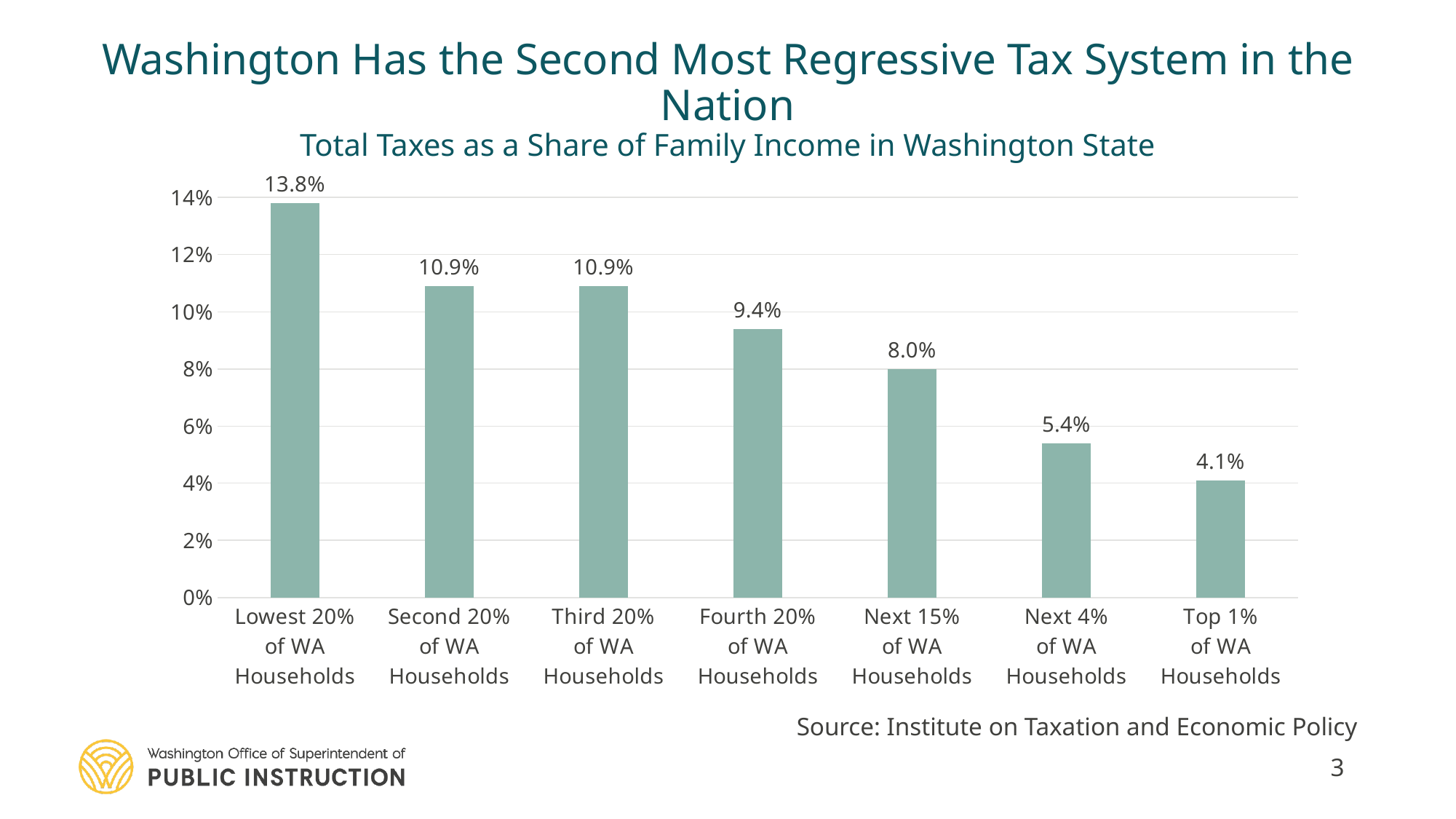
What is the value for the Next 15% of WA Households? 8.0% Which category has the highest total taxes as a share of family income? Lowest 20% of WA Households What is the value for the Lowest 20% of WA Households? 13.8% What is the difference between the values for the Lowest 20% and the Top 1% of WA Households? 9.7% Which category has the lowest total taxes as a share of family income? Top 1% of WA Households What is the value for the Top 1% of WA Households? 4.1% Is the value for the Next 4% of WA Households greater or less than 6%? less What is the difference between the values for the Fourth 20% and the Next 4% of WA Households? 4.0% What kind of chart is shown on the slide? Bar chart How many household categories are shown on the chart? 7 Which is larger, the value for the Fourth 20% or the Next 15% of WA Households? Fourth 20% of WA Households Do the values rise or fall moving from the Lowest 20% to the Top 1% of WA Households? Fall